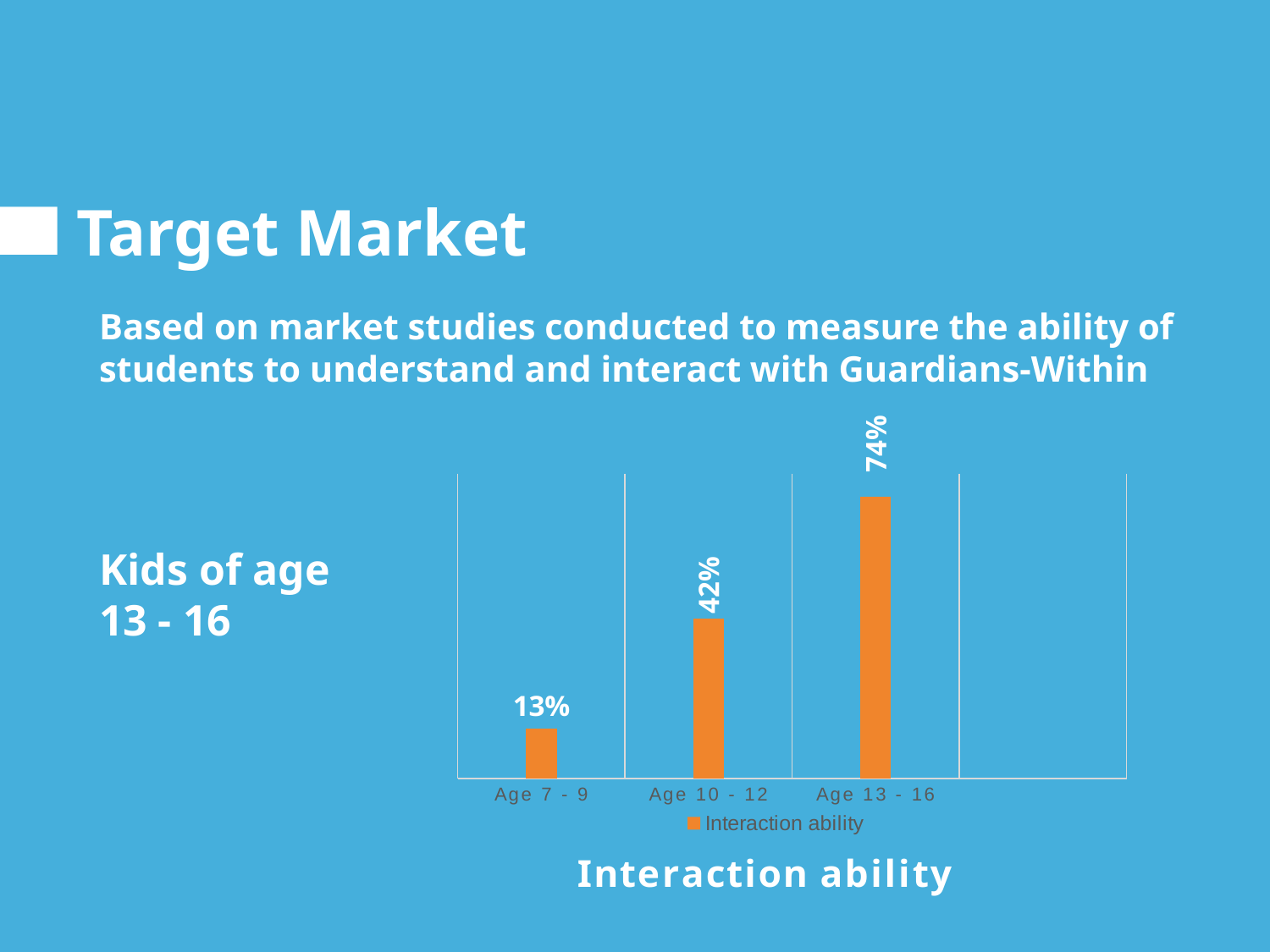
What is the interaction ability value for Age 13 - 16? 74% How many series does the chart legend list? 1 What is the difference in interaction ability between Age 10 - 12 and Age 7 - 9? 29% Which age group has the highest interaction ability? Age 13 - 16 What is the interaction ability value for Age 10 - 12? 42% What is the difference in interaction ability between Age 13 - 16 and Age 10 - 12? 32% What kind of chart is shown on the slide? Bar chart What is the interaction ability value for Age 7 - 9? 13% Which has a higher interaction ability, Age 7 - 9 or Age 10 - 12? Age 10 - 12 How many age groups are plotted in the chart? 3 Which age group has the lowest interaction ability? Age 7 - 9 Do the interaction ability values rise or fall as age increases along the x axis? Rise